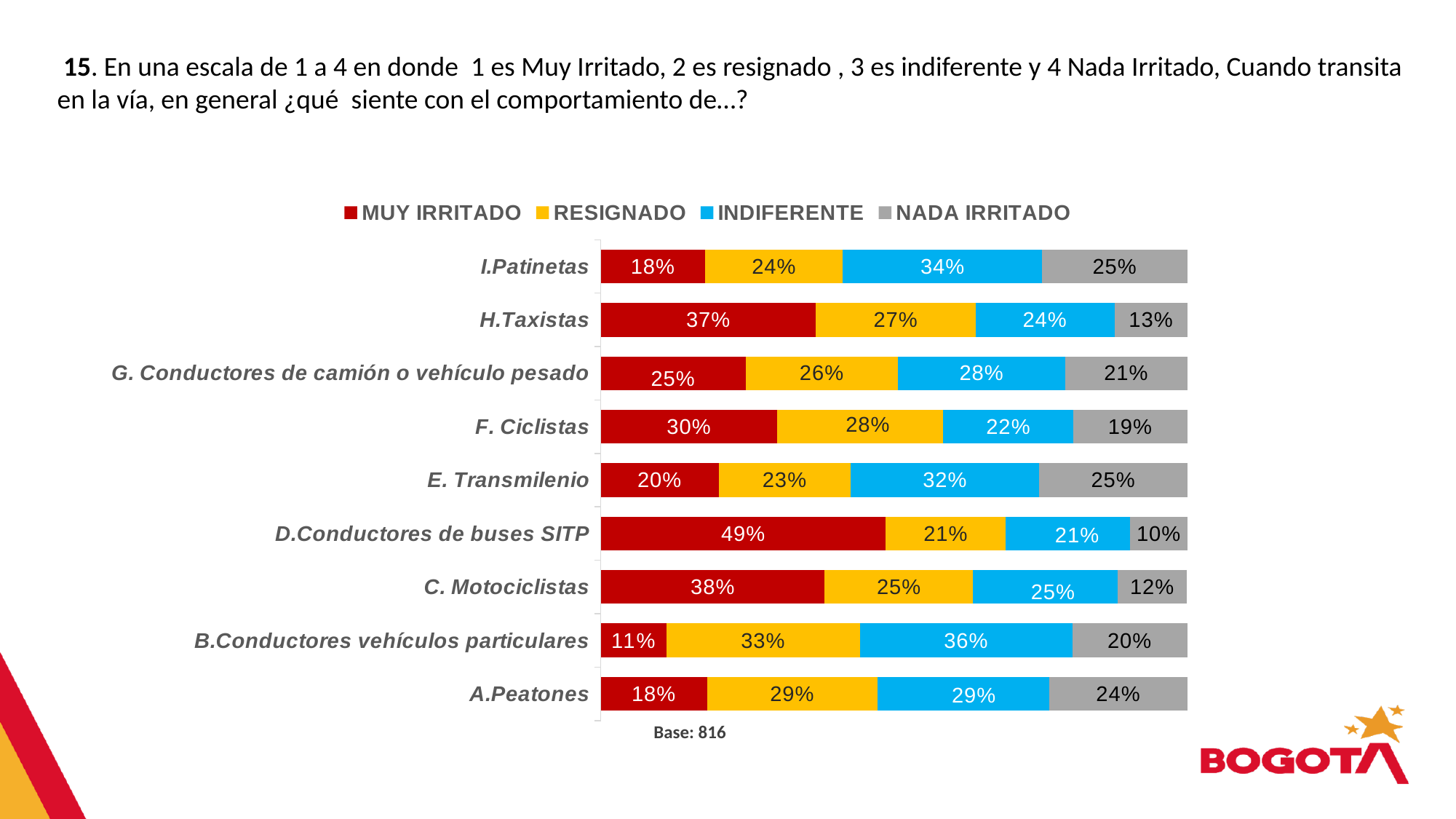
What kind of chart is shown on the slide? Stacked bar chart What is the difference between the 'Muy irritado' values for H.Taxistas and I.Patinetas? 19% Which category has the lowest 'Muy irritado' percentage? B.Conductores vehículos particulares What is the 'Nada irritado' value for H.Taxistas? 13% What colour represents the 'Resignado' series in the chart? Yellow What percentage of respondents are 'Muy irritado' with D.Conductores de buses SITP? 49% Which category has the highest 'Muy irritado' percentage? D.Conductores de buses SITP Which has a larger 'Indiferente' value, I.Patinetas or F. Ciclistas? I.Patinetas What is the 'Resignado' value for A.Peatones? 29% How many series does the legend list? 4 How many categories are shown in the chart? 9 What is the 'Indiferente' value for B.Conductores vehículos particulares? 36%